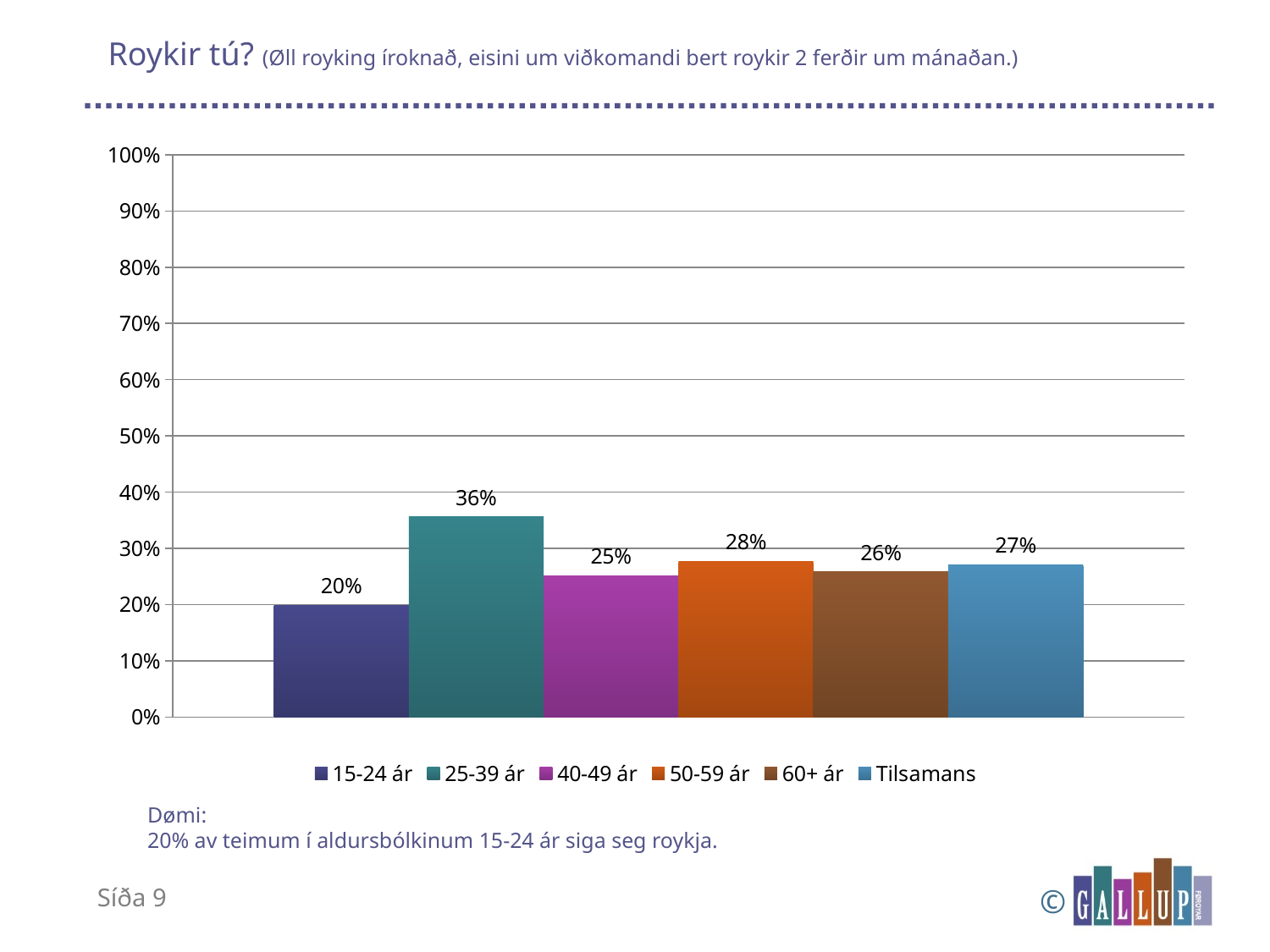
How many bars are plotted in the chart? 6 How many entries does the legend list? 6 What is the value shown for the 60+ ár group? 26% Which is larger, the value for 50-59 ár or the value for 40-49 ár? 50-59 ár What is the difference in percentage points between the 25-39 ár group and the 15-24 ár group? 16 percentage points What kind of chart is shown on the slide? Bar chart Is the value for the 25-39 ár group greater or less than 30%? greater Which age group has the highest share of smokers? 25-39 ár What is the value shown for Tilsamans? 27% Which age group has the lowest share of smokers? 15-24 ár What percentage of the 15-24 ár group say they smoke? 20% What is the value shown for the 25-39 ár group? 36%